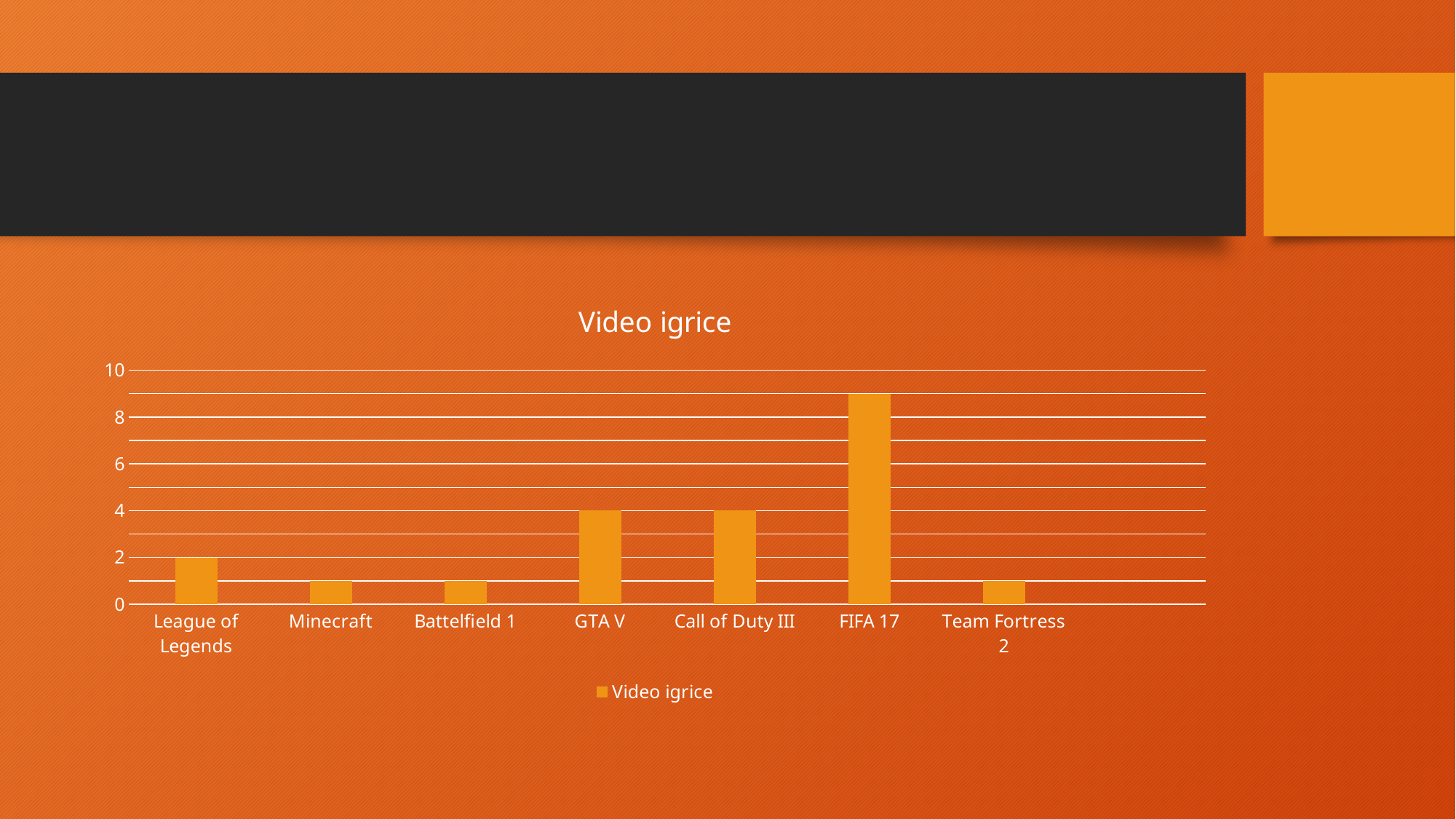
Which game has the highest bar in the chart? FIFA 17 What is the value for League of Legends? 2 What is the difference between the values for GTA V and League of Legends? 2 How many categories (games) are shown on the x axis of the chart? 7 What is the value for Call of Duty III? 4 What is the value for GTA V? 4 Which has a larger value, FIFA 17 or GTA V? FIFA 17 What is the title of the chart? Video igrice Is the value for FIFA 17 greater or less than 8? greater What type of chart is shown on the slide? bar chart Is the value for Minecraft greater or less than 2? less How many series does the chart's legend list? 1